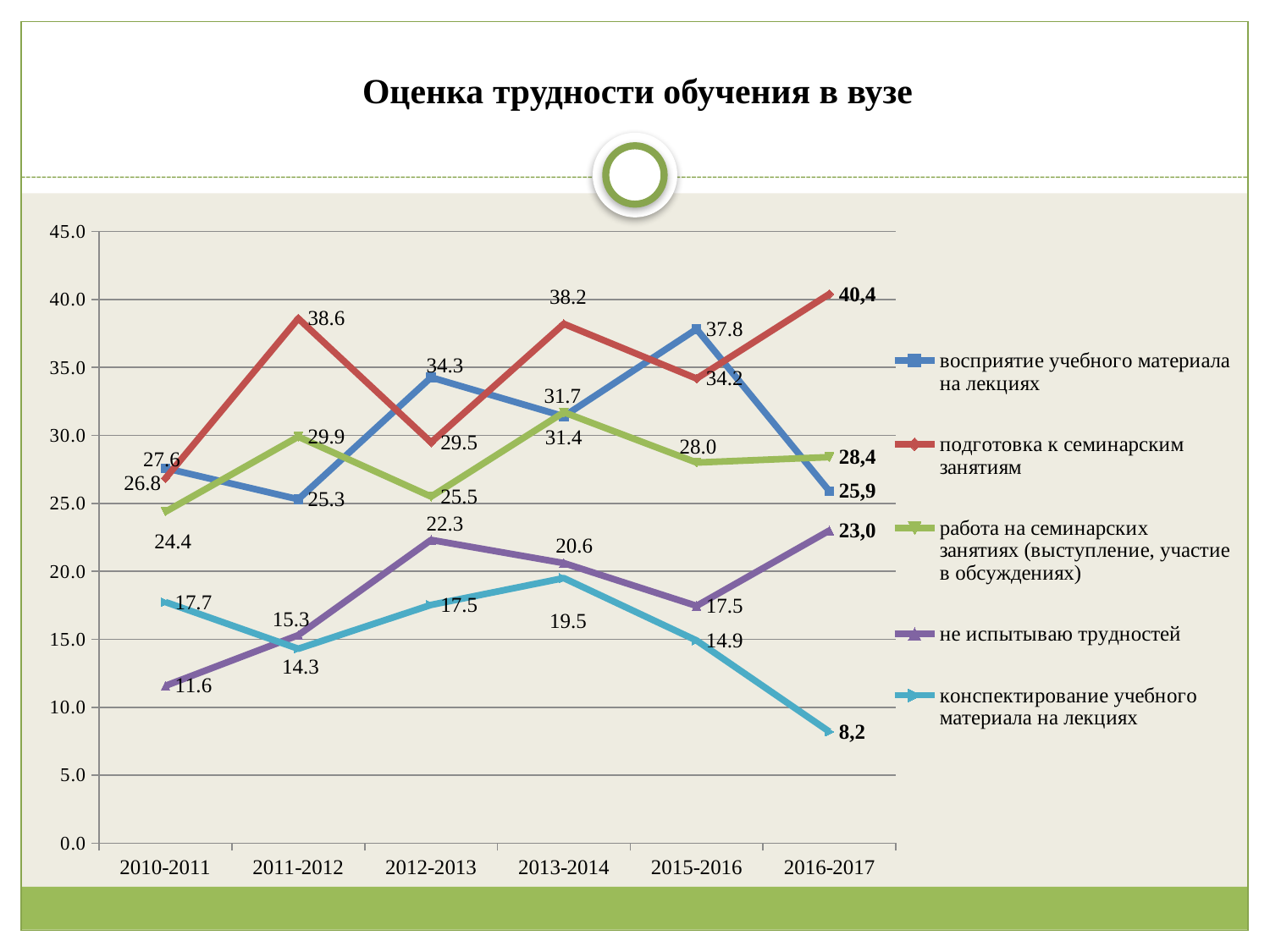
What kind of chart is shown on the slide? line chart How many academic years are shown on the x axis? 6 What is the value for не испытываю трудностей in 2012-2013? 22.3 How many series does the legend list? 5 What is the value for конспектирование учебного материала на лекциях in 2010-2011? 17.7 In which academic year does подготовка к семинарским занятиям reach its highest value? 2016-2017 Is the value for не испытываю трудностей in 2010-2011 greater or less than 15.0? less By how much did восприятие учебного материала на лекциях fall from 2015-2016 to 2016-2017? 11.9 What is the value for подготовка к семинарским занятиям in 2016-2017? 40,4 In 2011-2012, which is larger: подготовка к семинарским занятиям or восприятие учебного материала на лекциях? подготовка к семинарским занятиям Does the value for не испытываю трудностей rise or fall from 2010-2011 to 2012-2013? rise In which academic year is конспектирование учебного материала на лекциях at its lowest? 2016-2017